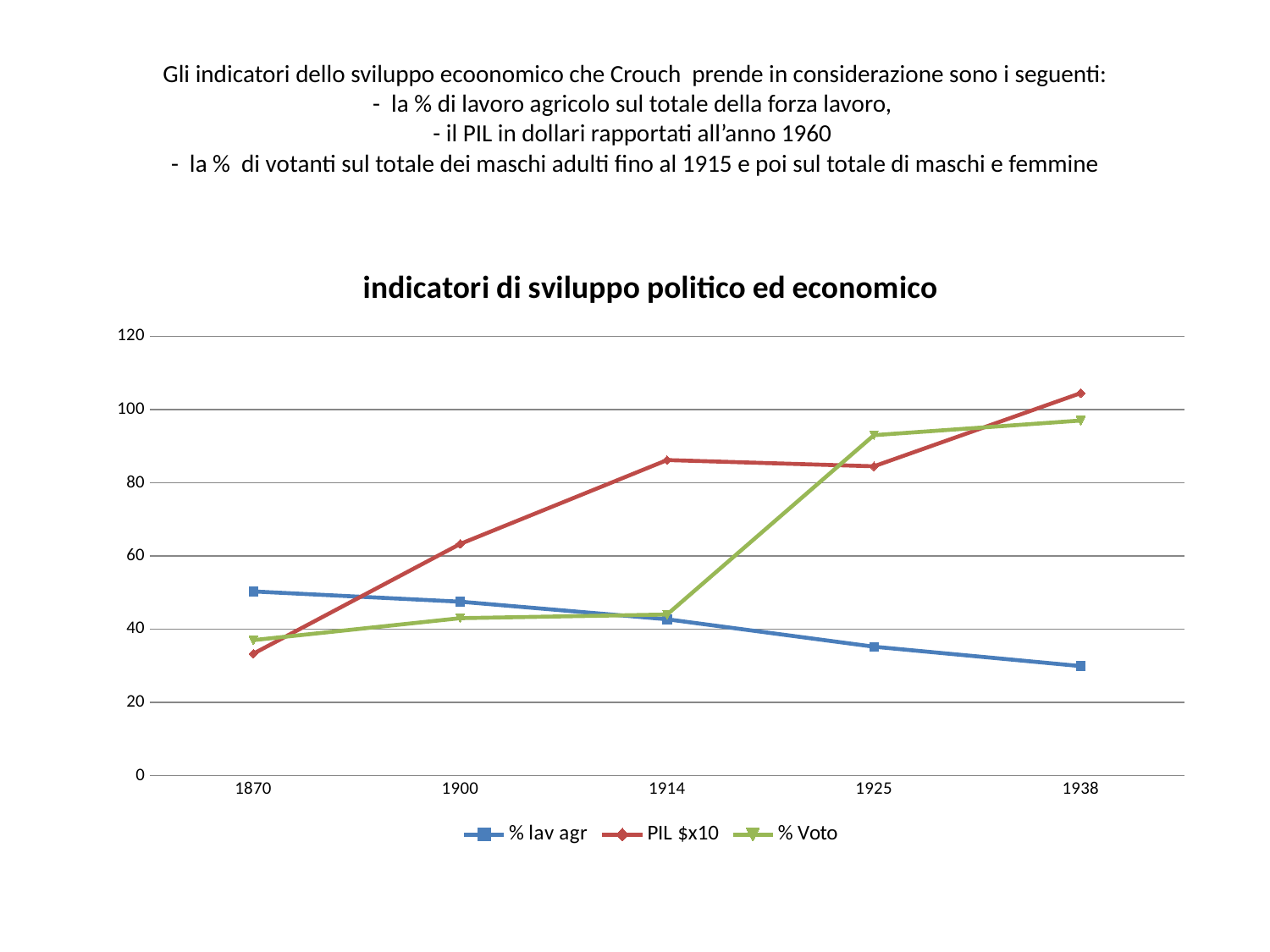
Is the value for PIL $x10 in 1938 greater or less than 100? greater How many series does the legend list? 3 In which year is the PIL $x10 series at its lowest? 1870 What kind of chart is shown on the slide? line chart What is the title of the chart? indicatori di sviluppo politico ed economico Is the value for % Voto in 1914 greater or less than 60? less In which year is the PIL $x10 series at its highest? 1938 How many years are plotted along the x axis? 5 Is the value for % lav agr in 1938 greater or less than 40? less In 1870, which is larger: % lav agr or PIL $x10? % lav agr In which year is the % lav agr series at its lowest? 1938 Does the % lav agr series rise or fall from 1870 to 1938? fall